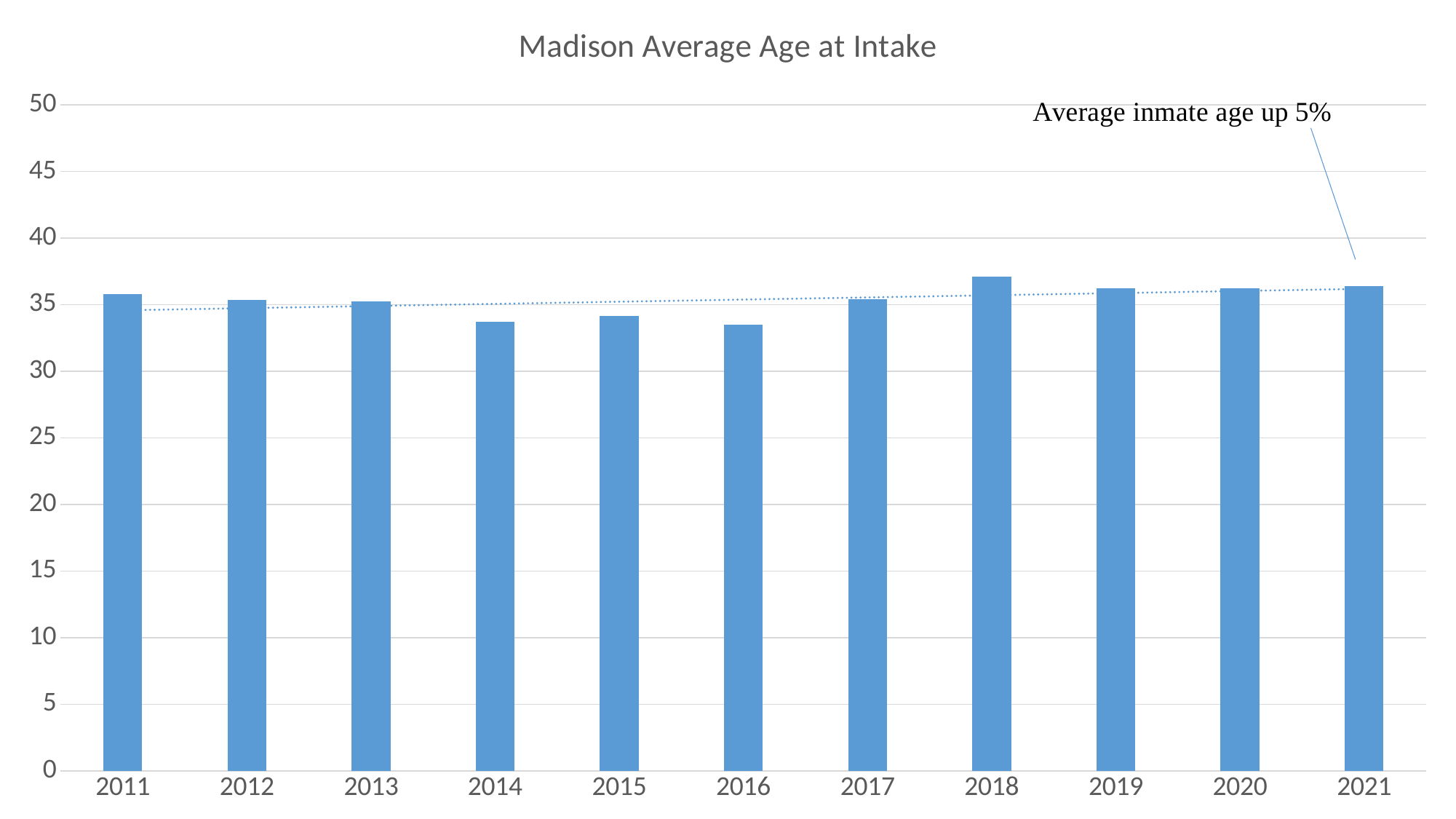
Is the value for 2014 greater or less than 35? less What is the title of the chart? Madison Average Age at Intake Is the value for 2021 greater or less than 40? less How many years are shown on the x axis of the chart? 11 Which is larger, the value for 2011 or the value for 2014? 2011 Does the dotted trend line on the chart rise or fall from 2011 to 2021? Rise What type of chart is shown on the slide? Bar chart What does the annotation text on the chart say? Average inmate age up 5% Which is larger, the value for 2018 or the value for 2016? 2018 Is the value for 2016 greater or less than 35? less Which year has the highest average age at intake? 2018